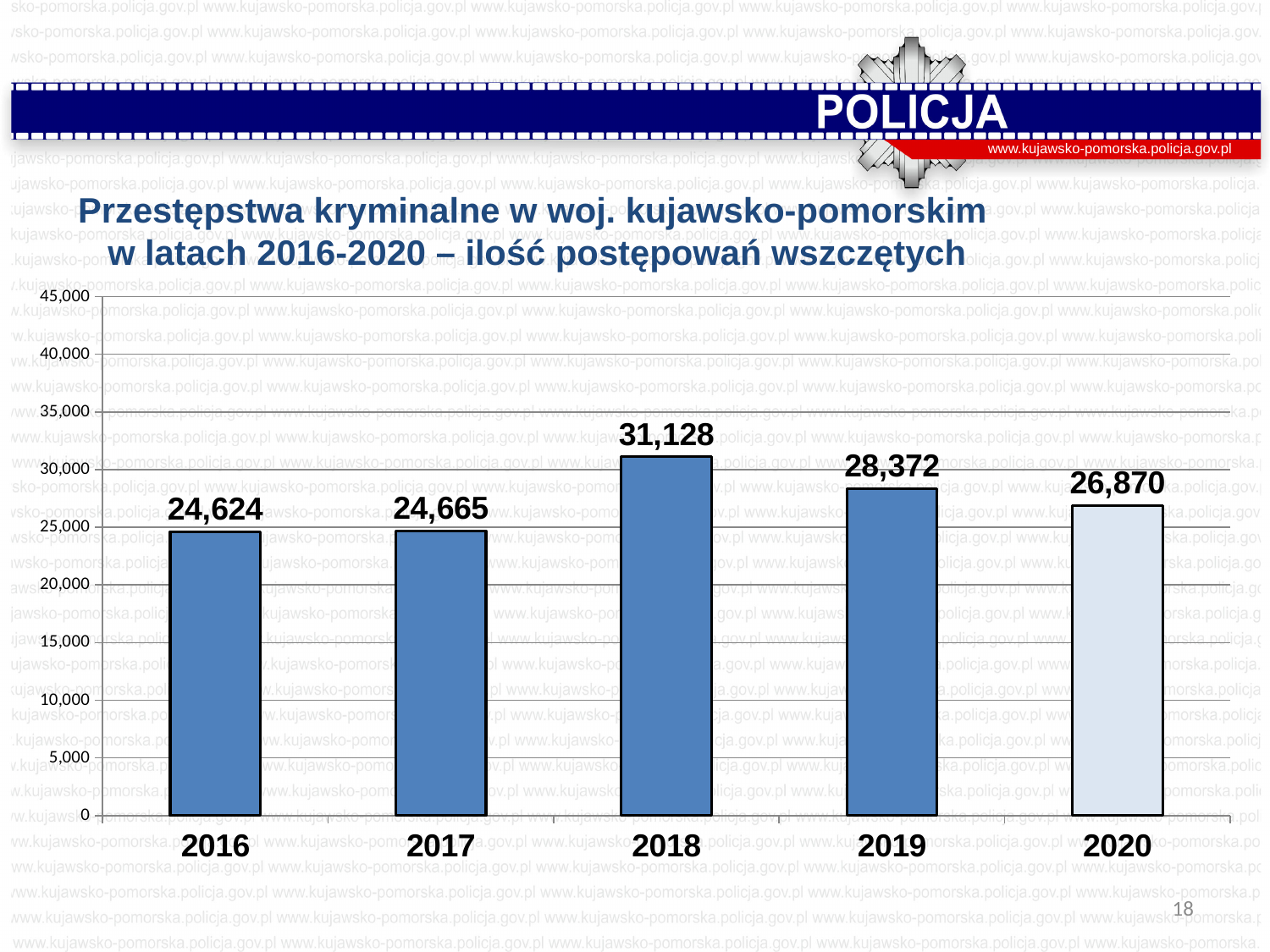
What is the title of the chart? Przestępstwa kryminalne w woj. kujawsko-pomorskim w latach 2016-2020 – ilość postępowań wszczętych What kind of chart is shown on the slide? bar chart What is the difference between the values for 2018 and 2019? 2,756 How many years are shown on the chart? 5 What is the value for 2018? 31,128 Is the value for 2018 greater or less than 30,000? greater Which year has the highest value? 2018 What is the value for 2020? 26,870 What is the value for 2016? 24,624 What is the difference between the values for 2017 and 2016? 41 Which year has the lowest value? 2016 Which is larger, the value for 2019 or the value for 2020? 2019